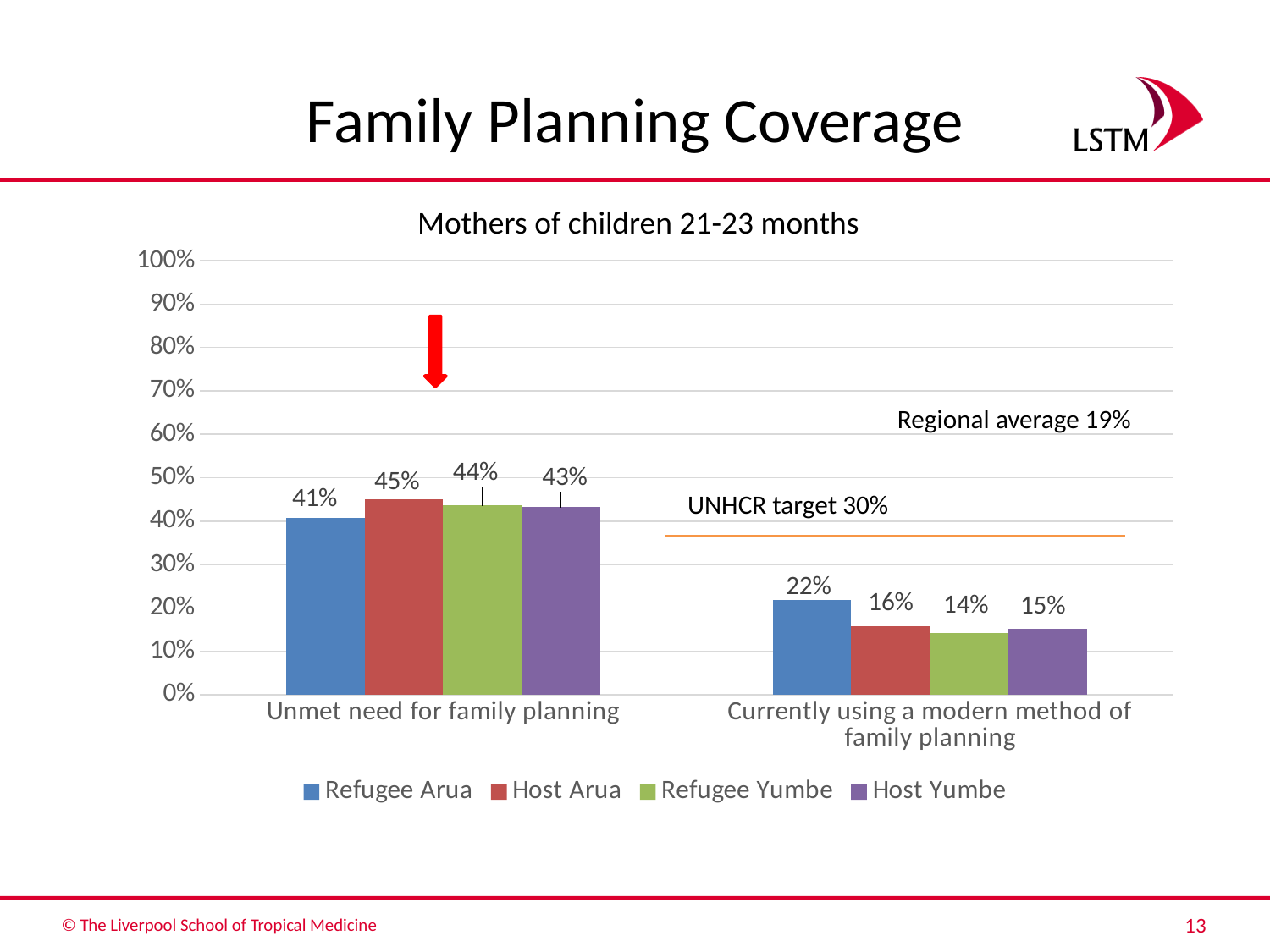
Is the value for Refugee Arua under 'Currently using a modern method of family planning' greater or less than 30%? less How many series does the legend list? 4 What kind of chart is shown on the slide? bar chart How many categories are shown on the x axis? 2 What is the title of the chart? Mothers of children 21-23 months Which series has the lowest value for 'Currently using a modern method of family planning'? Refugee Yumbe What is the value for Refugee Yumbe under 'Unmet need for family planning'? 44% What is the value for Host Arua under 'Currently using a modern method of family planning'? 16% Which is larger: the Host Yumbe value for 'Unmet need for family planning' or the Host Yumbe value for 'Currently using a modern method of family planning'? Unmet need for family planning What is the difference between the Refugee Arua values for 'Unmet need for family planning' and 'Currently using a modern method of family planning'? 19% What is the value for Refugee Arua under 'Unmet need for family planning'? 41% Which series has the highest value for 'Unmet need for family planning'? Host Arua